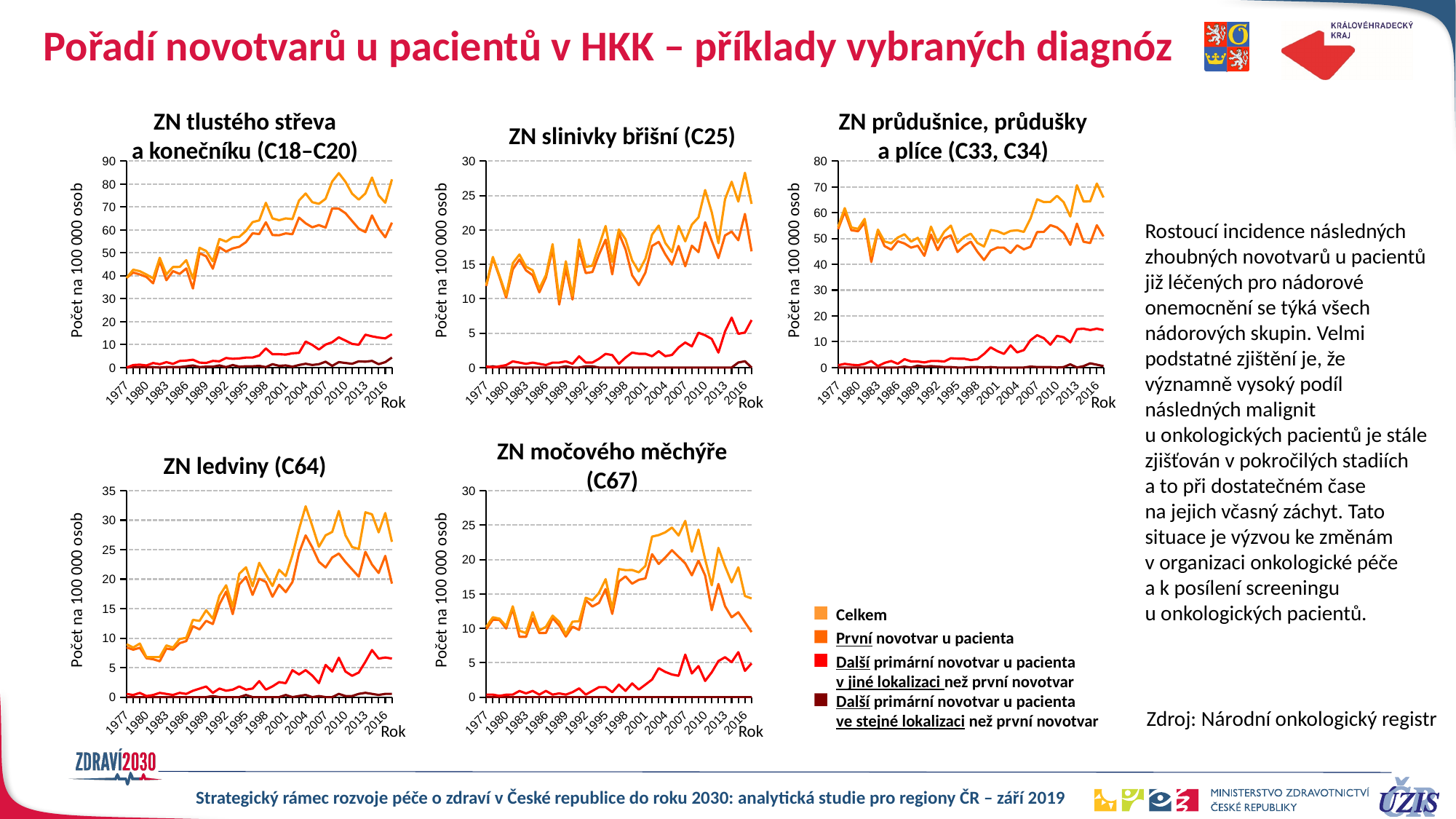
What is the x-axis label of the chart "ZN močového měchýře (C67)"? Rok In the chart "ZN slinivky břišní (C25)", is the value for Celkem in 1977 greater or less than 20? less In the chart "ZN průdušnice, průdušky a plíce (C33, C34)", is the value for Celkem in 2016 greater or less than 60? greater In the chart "ZN průdušnice, průdušky a plíce (C33, C34)", which is larger: the Celkem value in 1977 or in 2016? 2016 How many charts are shown on the slide? 5 What kind of chart is "ZN ledviny (C64)"? line chart How many series does the legend on the slide list? 4 In the chart "ZN močového měchýře (C67)", does the Celkem line rise or fall from 2007 to 2016? fall In the chart "ZN ledviny (C64)", is the value for "Další primární novotvar u pacienta v jiné lokalizaci než první novotvar" in 2016 greater or less than 10? less What is the y-axis label of the chart "ZN slinivky břišní (C25)"? Počet na 100 000 osob In the chart "ZN ledviny (C64)", does the Celkem line rise or fall from 1977 to 2016? rise